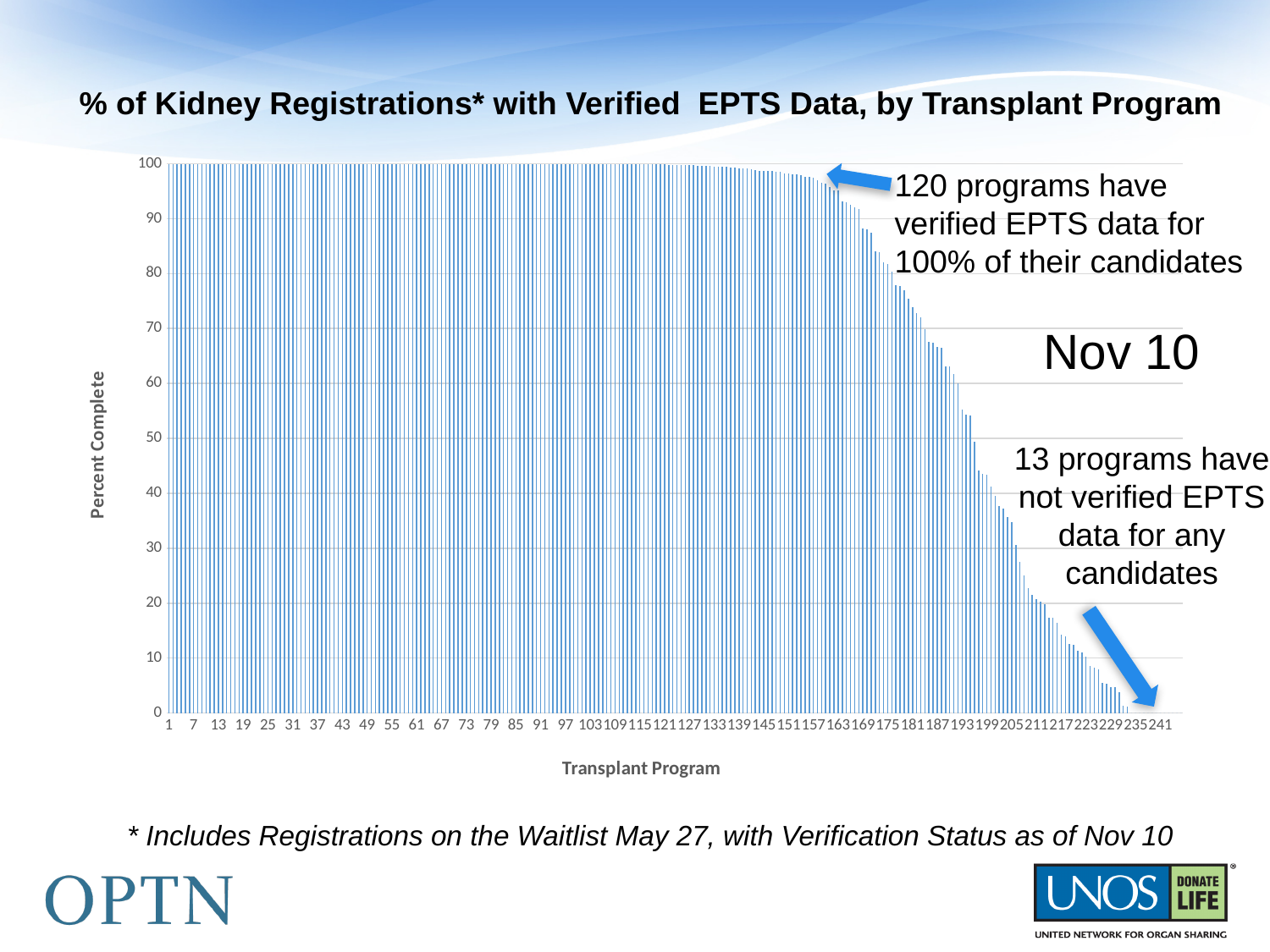
According to the annotation, how many programs have not verified EPTS data for any candidates? 13 What is the title of the chart? % of Kidney Registrations* with Verified EPTS Data, by Transplant Program Which has the larger value, transplant program 7 or transplant program 235? transplant program 7 Is the value for transplant program 229 greater or less than 20? less Is the value for transplant program 205 greater or less than 50? less What is the label on the y axis? Percent Complete Is the value for transplant program 181 greater or less than 50? greater What is the value for transplant program 1? 100 What kind of chart is shown on the slide? bar chart According to the annotation, how many programs have verified EPTS data for 100% of their candidates? 120 Do the values rise or fall as the transplant program number increases along the x axis? fall